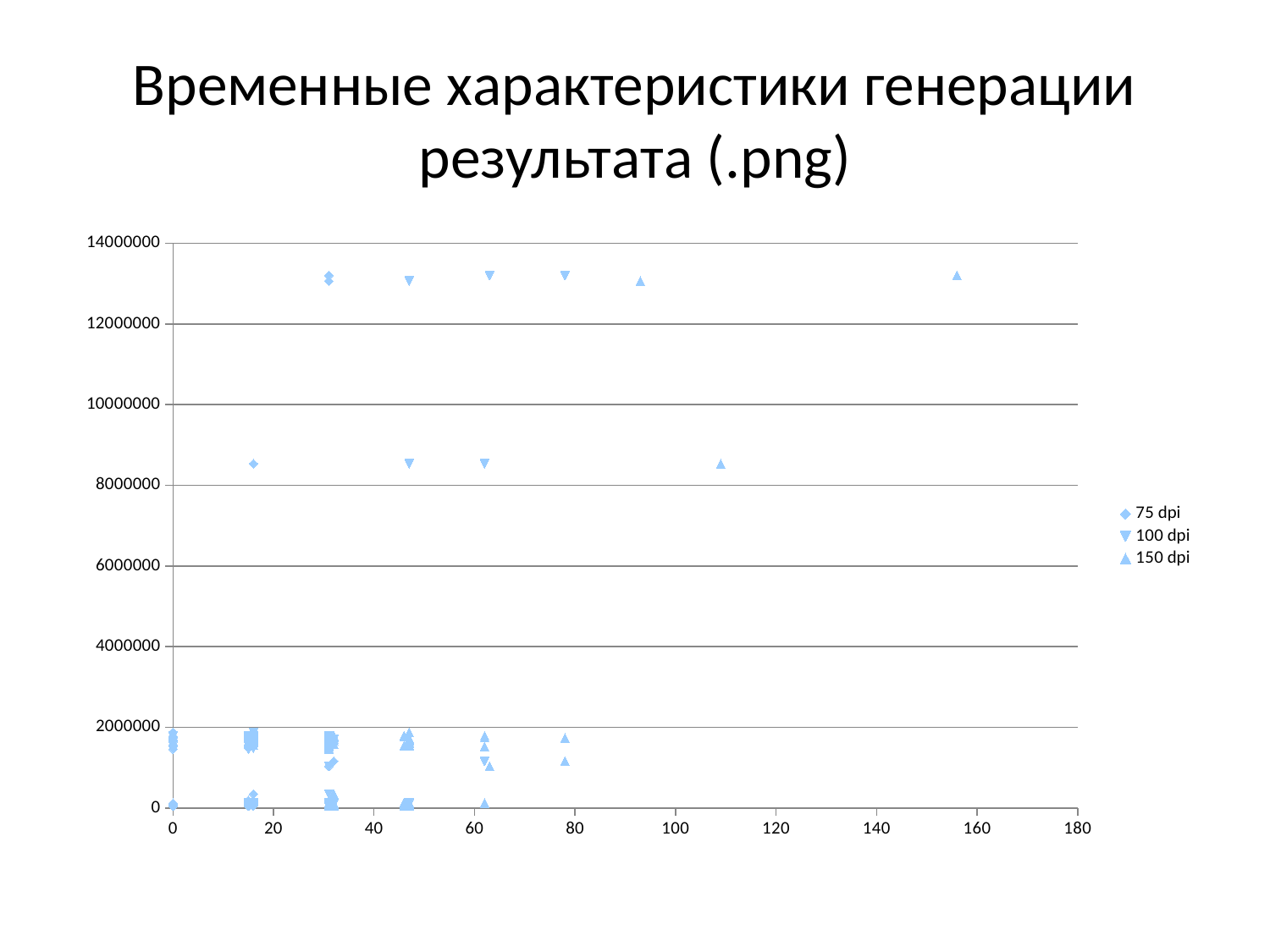
Is the value of the 150 dpi point plotted near x = 93 greater or less than 12000000? greater What is the maximum value shown on the vertical axis? 14000000 Is the value of the 75 dpi point plotted near x = 16 at about the 8500000 level greater or less than 8000000? greater Is the value of the 100 dpi point plotted near x = 47 at about the 8500000 level greater or less than 10000000? less What are the three series named in the legend? 75 dpi, 100 dpi, 150 dpi What kind of chart is shown on the slide? scatter chart Which series has the point with the largest x value on the chart? 150 dpi What is the title of the chart on the slide? Временные характеристики генерации результата (.png) How many series does the legend list? 3